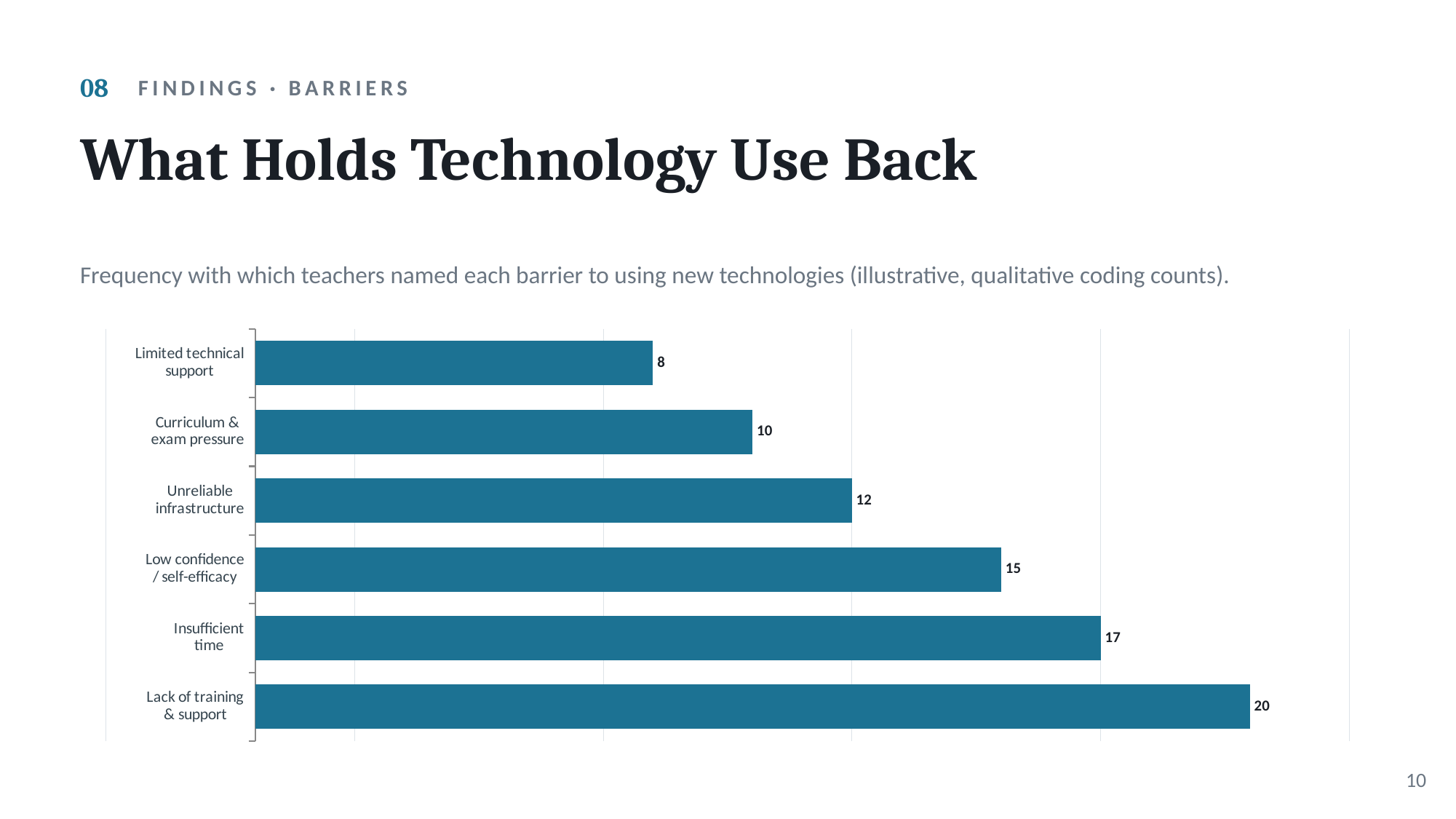
What is the value for Lack of training & support? 20 Which is larger, the value for Insufficient time or the value for Unreliable infrastructure? Insufficient time What is the difference between the values for Low confidence / self-efficacy and Limited technical support? 7 What kind of chart is shown on the slide? Bar chart Which barrier has the lowest value? Limited technical support Which barrier has the highest value? Lack of training & support What is the difference between the values for Lack of training & support and Insufficient time? 3 What is the value for Insufficient time? 17 What is the value for Curriculum & exam pressure? 10 What is the title of the slide containing the chart? What Holds Technology Use Back What is the value for Unreliable infrastructure? 12 How many barriers are shown in the chart? 6